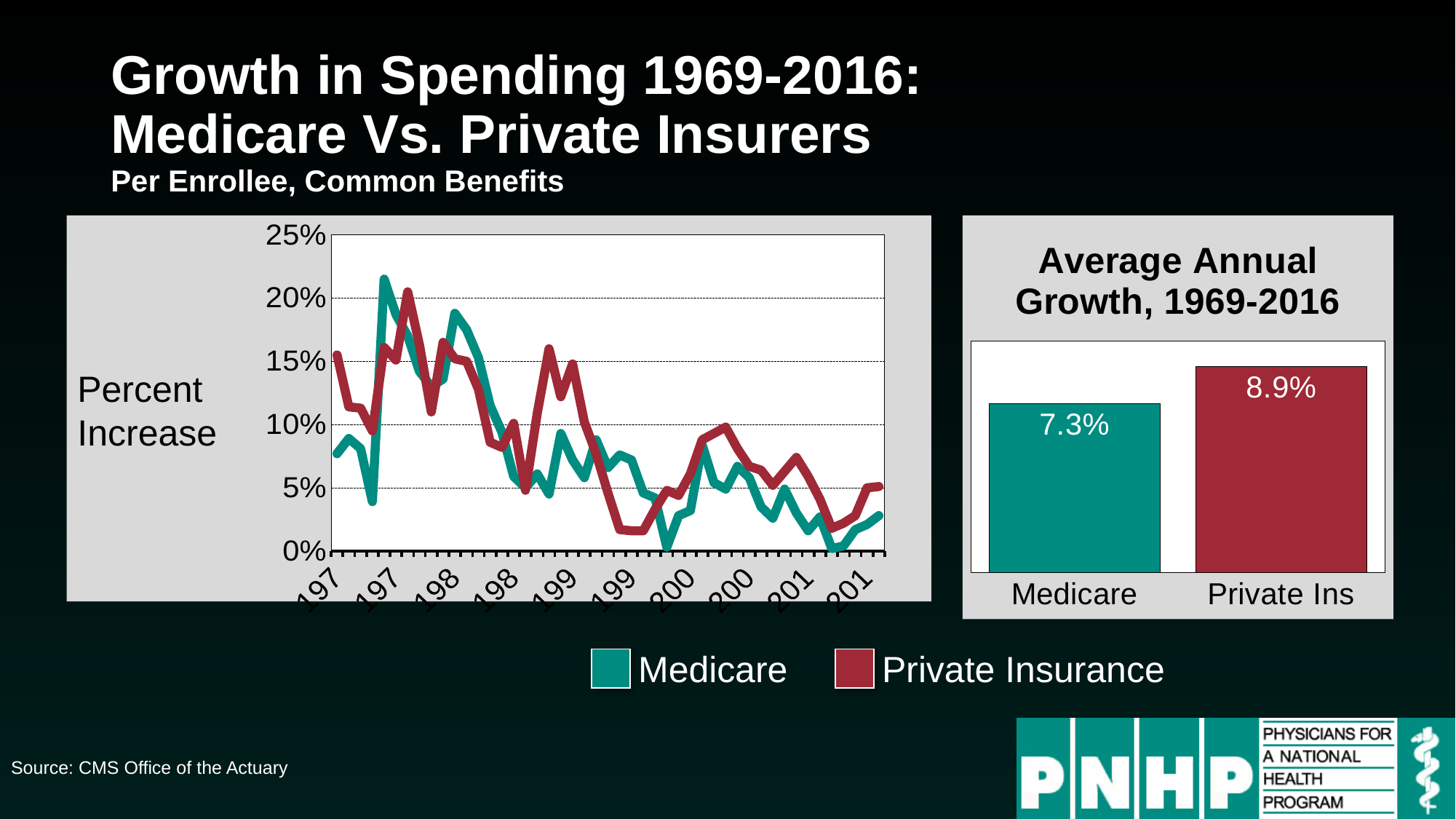
How many series does the legend list for the 'Percent Increase' line chart on the left? 2 How many categories are shown in the 'Average Annual Growth, 1969-2016' bar chart? 2 In the 'Average Annual Growth, 1969-2016' bar chart, which category has the highest value? Private Ins In the 'Percent Increase' line chart on the left, is the highest value reached by the Medicare line greater or less than 20%? greater In the 'Average Annual Growth, 1969-2016' bar chart, what is the difference between the Private Ins value and the Medicare value? 1.6% In the 'Average Annual Growth, 1969-2016' bar chart, is the value for Medicare larger or smaller than the value for Private Ins? smaller In the 'Average Annual Growth, 1969-2016' bar chart, what is the value for Medicare? 7.3% In the 'Average Annual Growth, 1969-2016' bar chart, which category has the lowest value? Medicare In the 'Percent Increase' line chart on the left, do the values generally rise or fall from left to right along the x axis? fall What kind of chart is the 'Average Annual Growth, 1969-2016' chart on the right of the slide? bar chart In the 'Average Annual Growth, 1969-2016' bar chart, what is the value for Private Ins? 8.9% What kind of chart is the 'Percent Increase' chart on the left of the slide? line chart